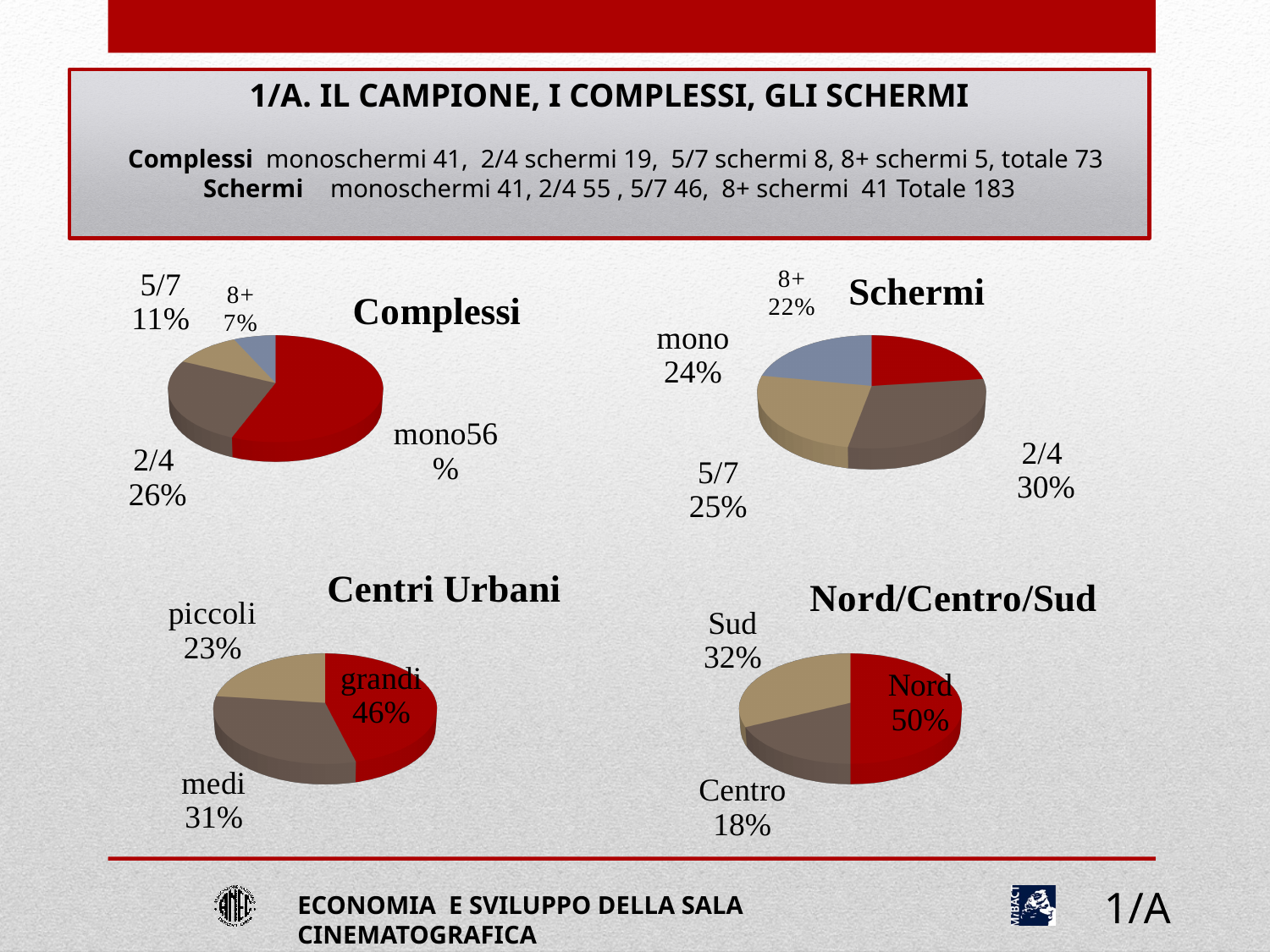
In the "Nord/Centro/Sud" chart, what share does the "Centro" slice have? 18% How many pie charts are shown on the slide? 4 In the "Complessi" chart, what share does the "mono" slice have? 56% What kind of chart is the "Complessi" chart? pie chart In the "Schermi" chart, what share does the "2/4" slice have? 30% In the "Schermi" chart, which category has the largest share? 2/4 In the "Nord/Centro/Sud" chart, what is the difference between the shares of "Nord" and "Sud"? 18% In the "Complessi" chart, which category has the smallest share? 8+ In the "Complessi" chart, what is the difference between the shares of "2/4" and "5/7"? 15% In the "Centri Urbani" chart, which is larger, "grandi" or "piccoli"? grandi How many slices does the "Schermi" chart have? 4